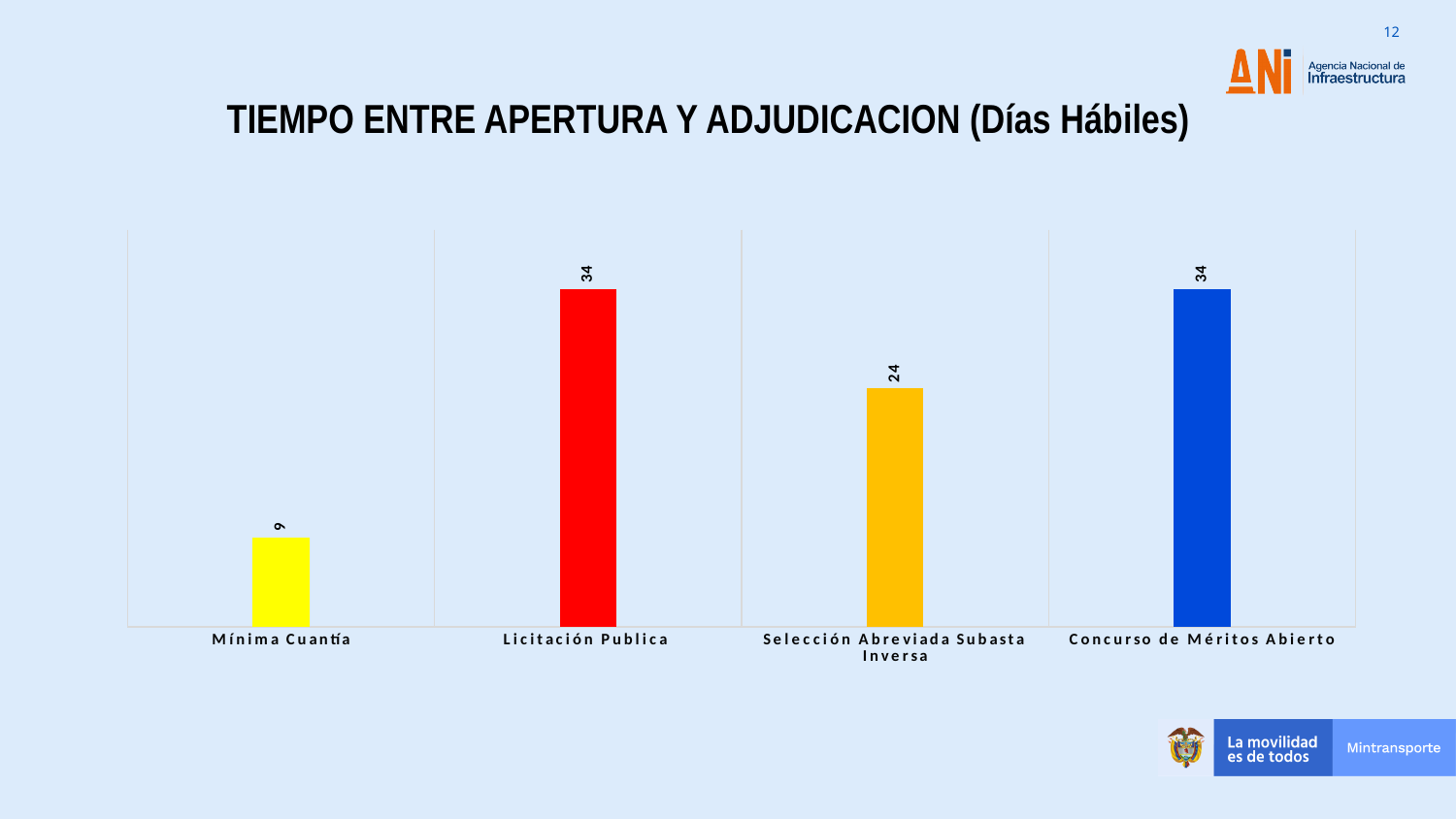
What is the difference between the values for Concurso de Méritos Abierto and Mínima Cuantía? 25 What is the title of the chart? TIEMPO ENTRE APERTURA Y ADJUDICACION (Días Hábiles) Which is larger, the value for Selección Abreviada Subasta Inversa or the value for Mínima Cuantía? Selección Abreviada Subasta Inversa What is the value for Concurso de Méritos Abierto? 34 What kind of chart is shown on the slide? Bar chart What is the value for Licitación Publica? 34 What is the difference between the values for Licitación Publica and Selección Abreviada Subasta Inversa? 10 What is the value for Selección Abreviada Subasta Inversa? 24 How many categories are shown in the chart? 4 Which category has the lowest value? Mínima Cuantía What is the value for Mínima Cuantía? 9 What is the difference between the values for Selección Abreviada Subasta Inversa and Mínima Cuantía? 15